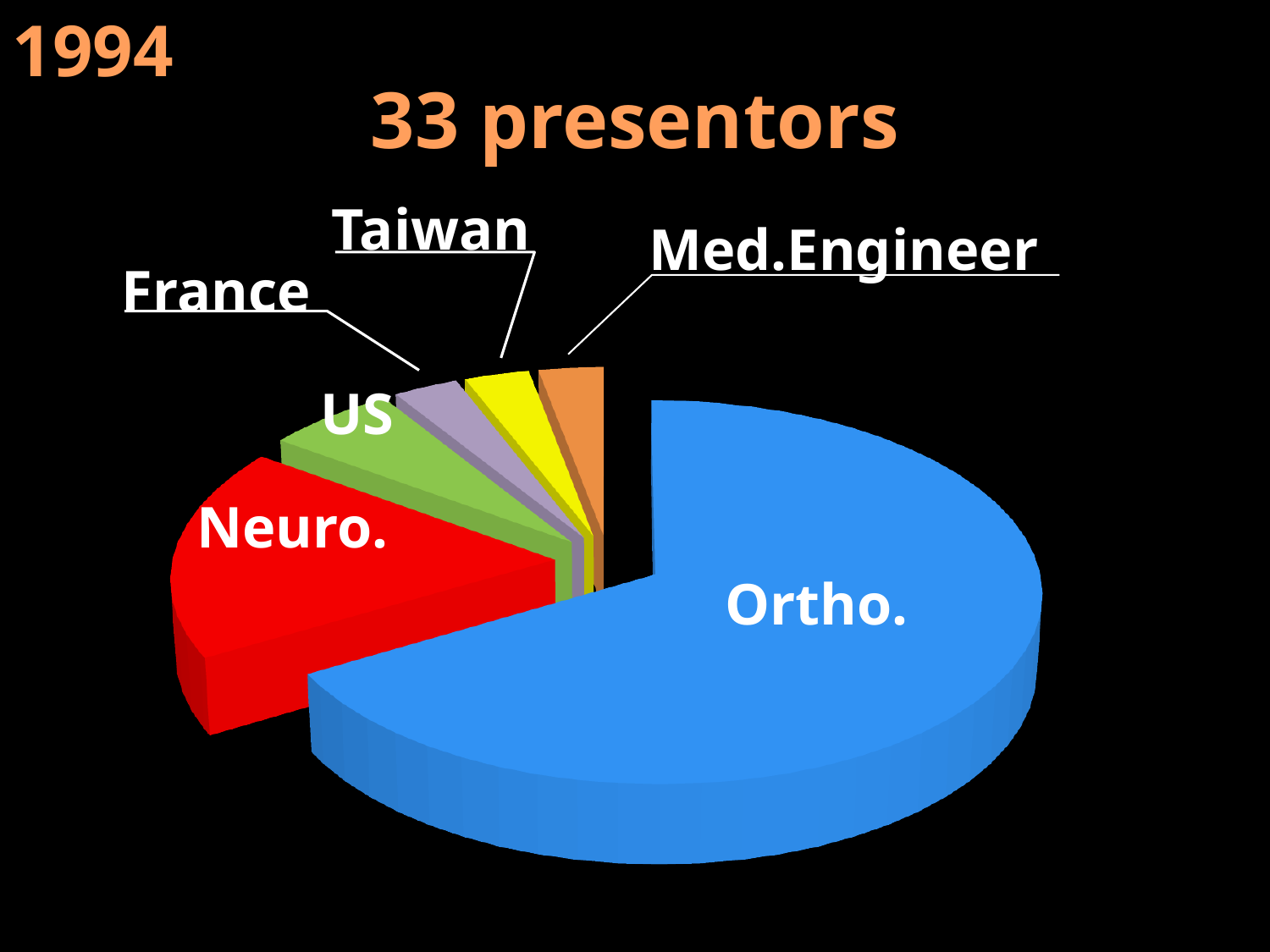
Which is larger, the Ortho. slice or the Neuro. slice? Ortho. Does the Ortho. slice account for more or less than half of the pie? more What colour is the Ortho. slice? blue Which is larger, the Neuro. slice or the US slice? Neuro. What kind of chart is shown on the slide? pie chart What is the title of the chart? 33 presentors Which category has the largest slice of the pie chart? Ortho. How many slices does the pie chart have? 6 Which category has the second-largest slice of the pie chart? Neuro. Which is larger, the US slice or the Taiwan slice? US